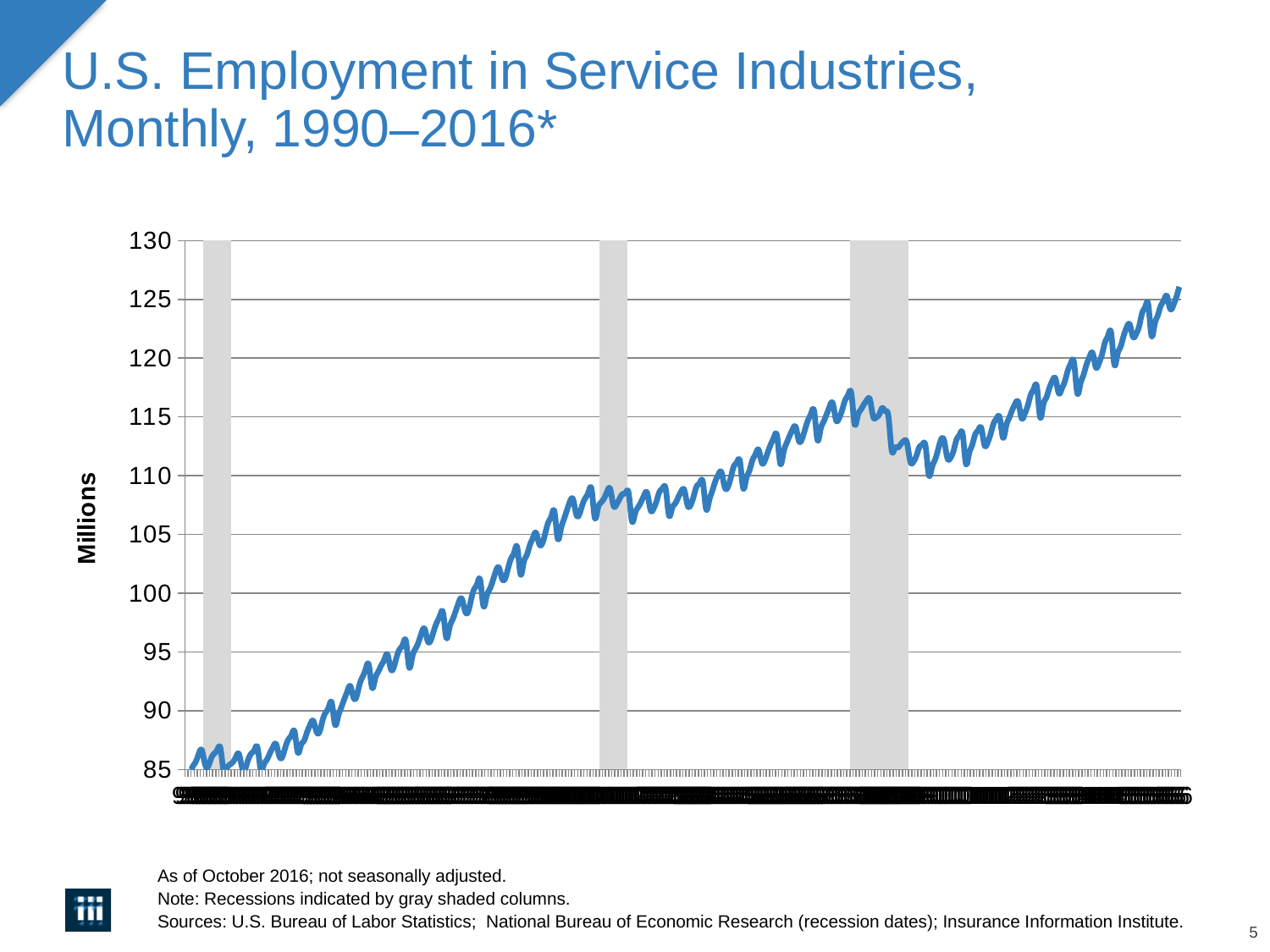
What is the lowest value shown on the vertical axis of the chart? 85 How many gray shaded recession columns are shown on the chart? 3 Is the value at the start of the series (1990) greater or less than 90? less What is the label on the vertical axis of the chart? Millions Which is larger, the value at the start of the series (1990) or the value at the end of the series (2016)? the end of the series (2016) Does the line fall or rise during the third (rightmost) gray shaded recession column? fall Is the value at the end of the series (2016) greater or less than 130? less What kind of chart is shown on the slide? line chart What is the title of the chart on the slide? U.S. Employment in Service Industries, Monthly, 1990–2016* Is the value at the end of the series (2016) greater or less than 120? greater Overall, do the values rise or fall from the start of the series in 1990 to the end in 2016? rise